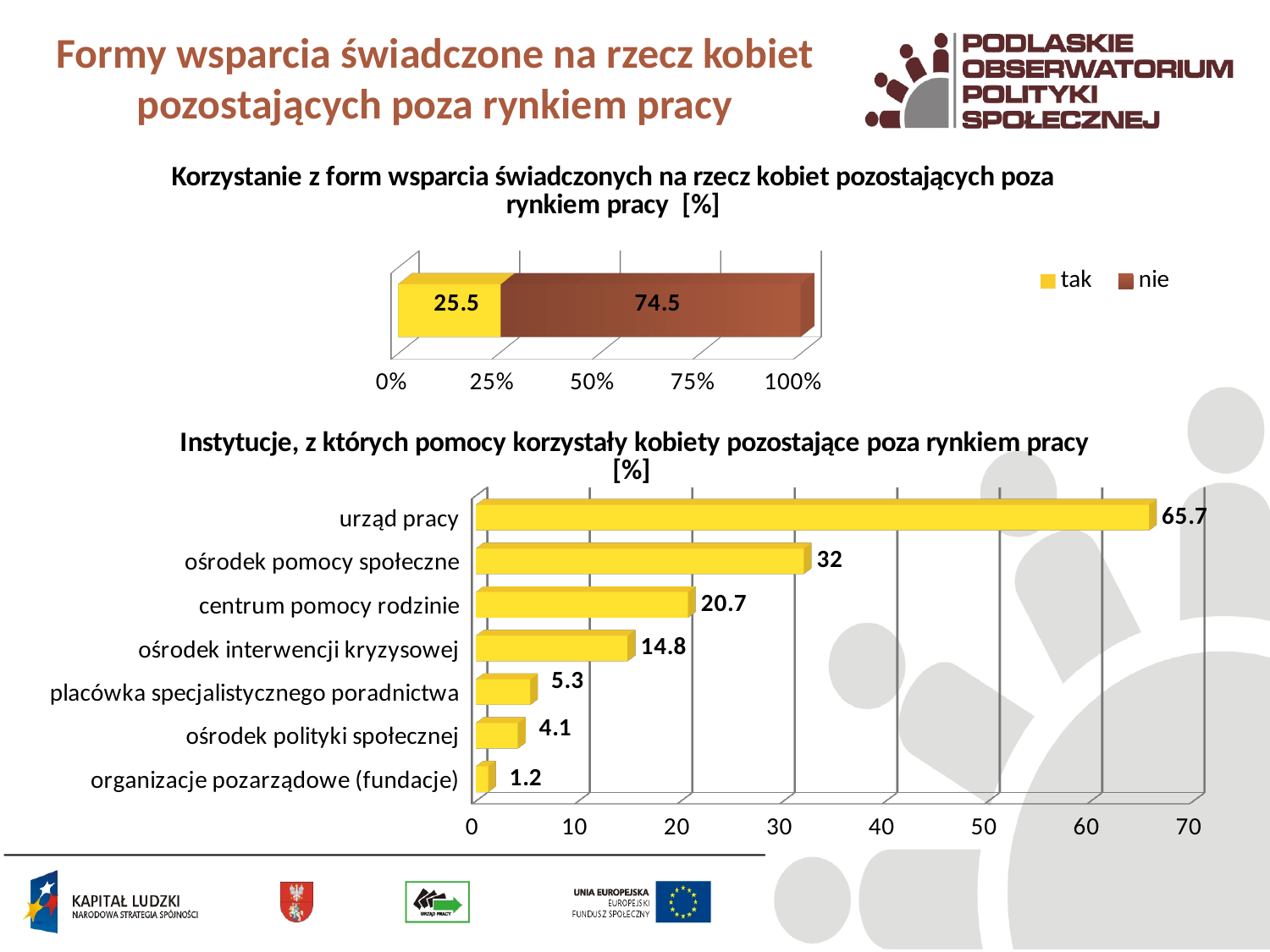
In the bottom chart (Instytucje, z których pomocy korzystały...), what is the value for 'urząd pracy'? 65.7 In the top chart (Korzystanie z form wsparcia...), what is the value for 'tak'? 25.5 In the bottom chart (Instytucje, z których pomocy korzystały...), what is the value for 'ośrodek interwencji kryzysowej'? 14.8 In the bottom chart (Instytucje, z których pomocy korzystały...), what is the difference between 'ośrodek pomocy społeczne' and 'centrum pomocy rodzinie'? 11.3 In the top chart (Korzystanie z form wsparcia...), what is the difference between 'nie' and 'tak'? 49 In the bottom chart (Instytucje, z których pomocy korzystały...), how many categories are shown? 7 In the top chart (Korzystanie z form wsparcia...), what is the value for 'nie'? 74.5 What kind of chart is the bottom chart (Instytucje, z których pomocy korzystały...)? bar chart In the top chart (Korzystanie z form wsparcia...), how many series does the legend list? 2 In the bottom chart (Instytucje, z których pomocy korzystały...), which category has the lowest value? organizacje pozarządowe (fundacje) In the top chart (Korzystanie z form wsparcia...), what is the total of the stacked bar? 100 In the bottom chart (Instytucje, z których pomocy korzystały...), which category has the highest value? urząd pracy